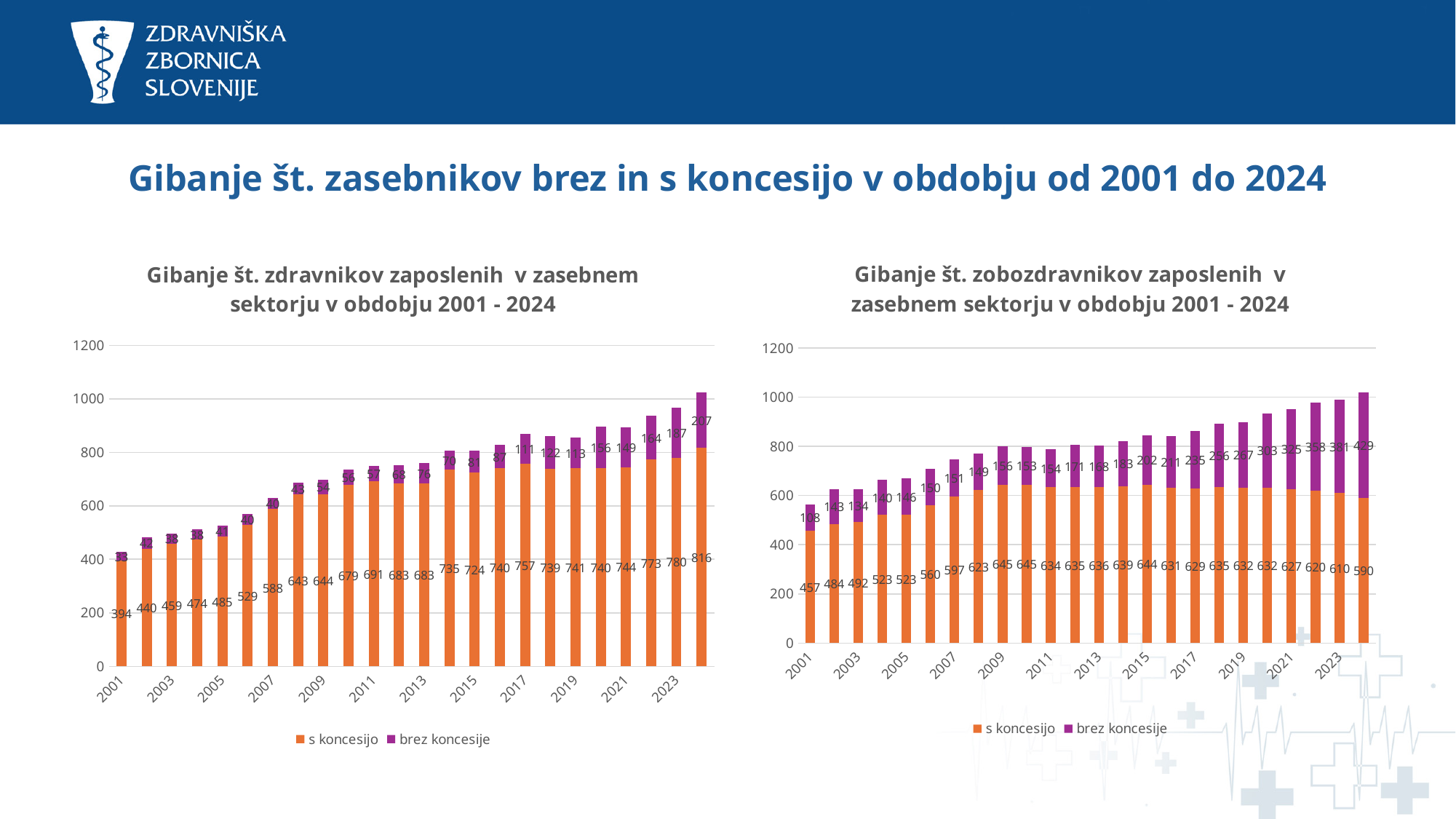
In the left chart (zdravnikov), what is the value of 's koncesijo' for 2024? 816 In the right chart (zobozdravnikov), what is the difference between the 'brez koncesije' values for 2024 and 2023? 48 In the right chart (zobozdravnikov), what is the value of 's koncesijo' for 2001? 457 What kind of chart is the left chart, 'Gibanje št. zdravnikov zaposlenih v zasebnem sektorju v obdobju 2001 - 2024'? Stacked bar chart How many years (bars) are plotted in the right chart (zobozdravnikov)? 24 In the left chart (zdravnikov), what is the value of 'brez koncesije' for 2024? 207 In the right chart (zobozdravnikov), does the 'brez koncesije' value generally rise or fall from 2001 to 2024? Rise In the left chart (zdravnikov), what is the total height of the stacked bar for 2024? 1023 In the right chart (zobozdravnikov), which year has the lowest 's koncesijo' value? 2001 How many series does the legend of the left chart (zdravnikov) list? 2 In the left chart (zdravnikov), which is larger: the 's koncesijo' value for 2022 or for 2021? 2022 In the right chart (zobozdravnikov), which year has the highest 'brez koncesije' value? 2024